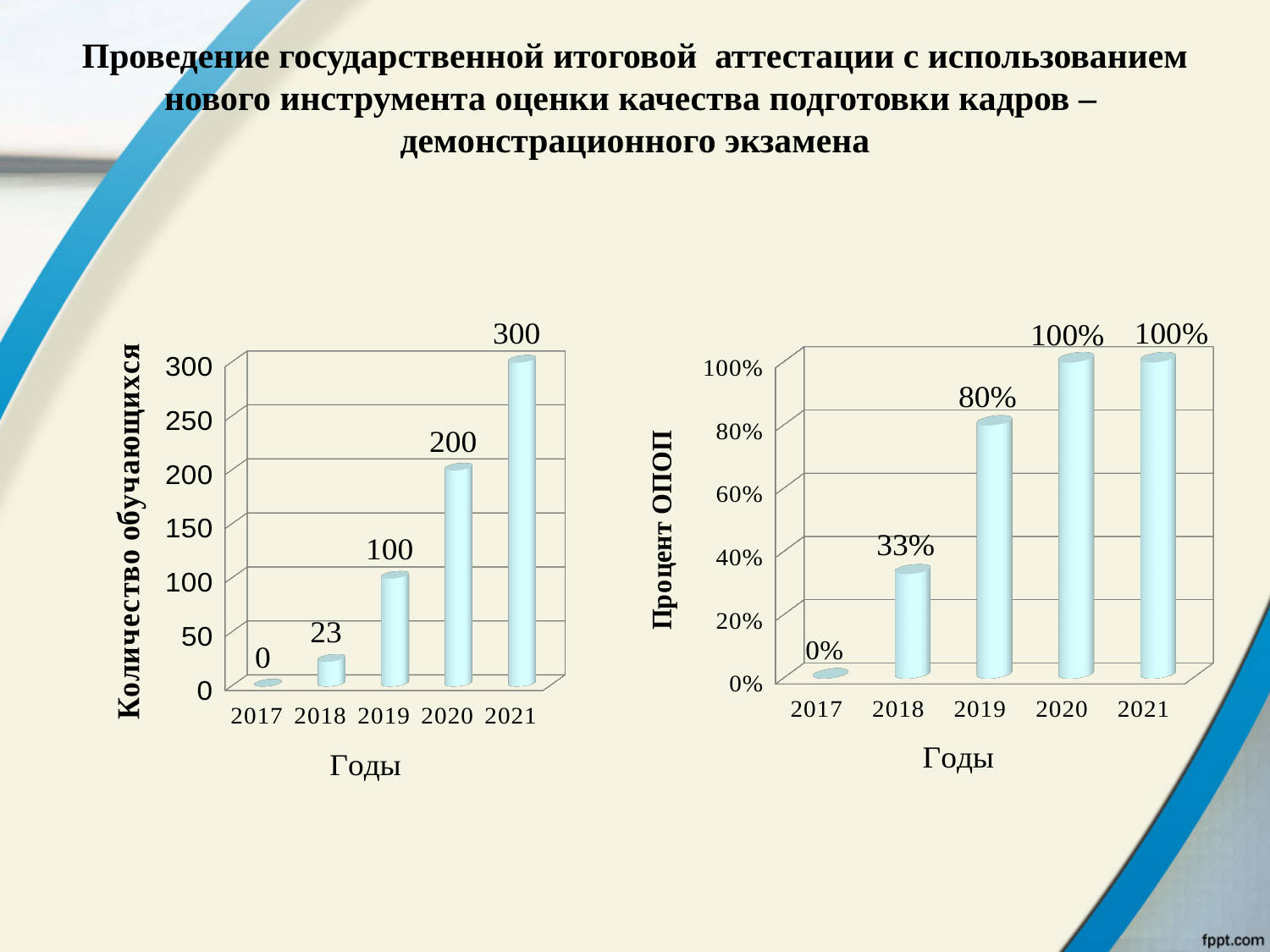
In the left chart (Количество обучающихся), which year has the highest value? 2021 In the left chart (Количество обучающихся), what is the difference between the values for 2021 and 2020? 100 In the left chart (Количество обучающихся), what is the value for 2018? 23 In the left chart (Количество обучающихся), how many years are shown on the x axis? 5 What kind of chart is the right chart (Процент ОПОП)? bar chart In the right chart (Процент ОПОП), what is the value for 2019? 80% In the left chart (Количество обучающихся), which year has the lowest value? 2017 In the right chart (Процент ОПОП), what is the value for 2018? 33% In the left chart (Количество обучающихся), do the values rise or fall from 2017 to 2021? rise In the right chart (Процент ОПОП), which is larger, the value for 2018 or the value for 2019? 2019 In the left chart (Количество обучающихся), what is the value for 2019? 100 In the right chart (Процент ОПОП), what is the difference between the values for 2019 and 2018? 47%